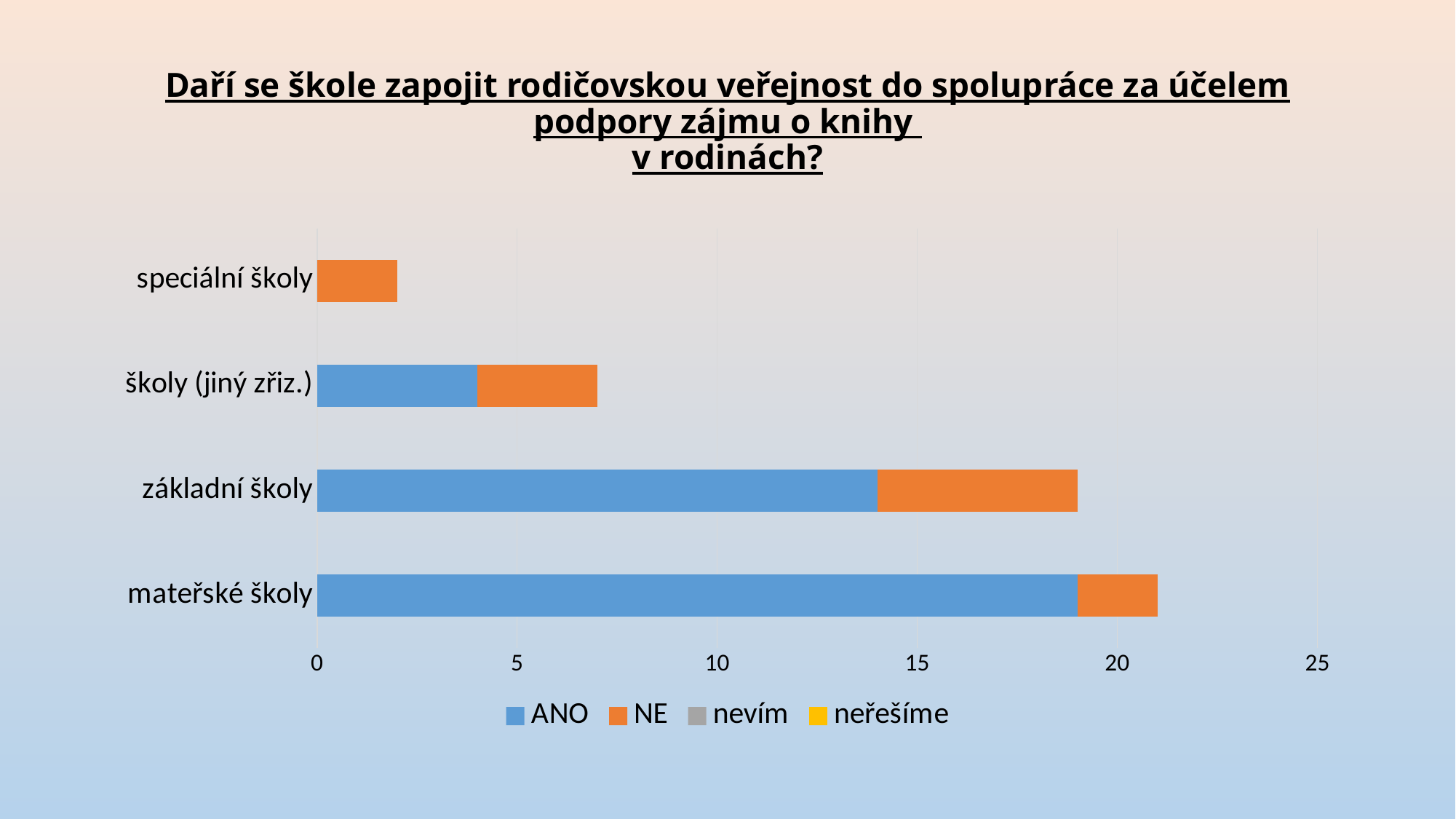
Which has a longer total bar: základní školy or školy (jiný zřiz.)? základní školy Is the total bar for základní školy greater or less than 20? less Is the total bar for speciální školy greater or less than 5? less Is the ANO value for mateřské školy greater or less than 15? greater How many series does the legend list? 4 Which category has the shortest total bar? speciální školy How many categories are shown on the chart? 4 Which category has no ANO segment in its bar? speciální školy What kind of chart is shown on the slide? bar chart Which category has the longest total bar? mateřské školy